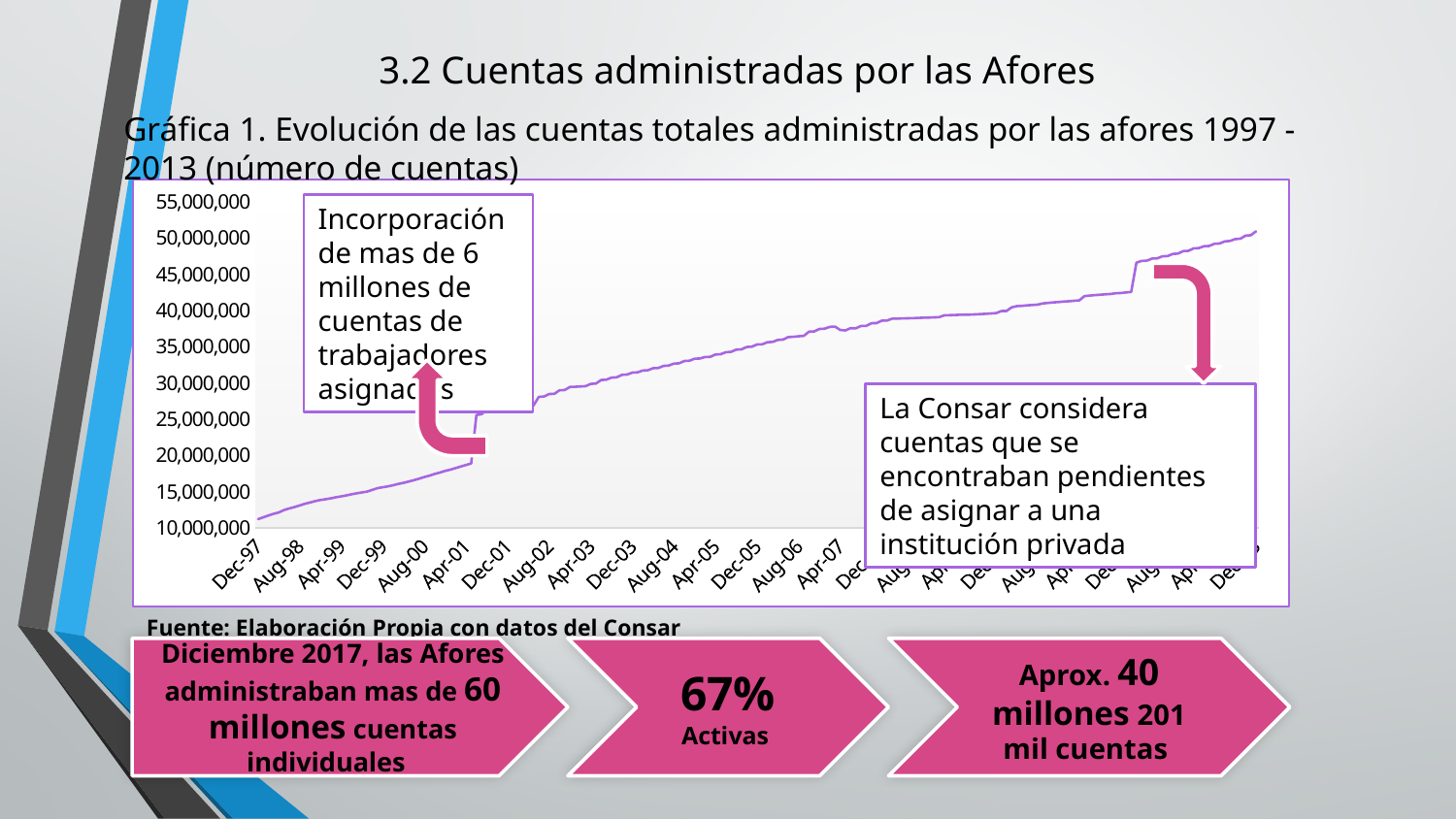
Which x-axis label corresponds to the lowest value on the line? Dec-97 Is the value at Apr-01 greater or less than 20,000,000? less Is the value at Dec-97 greater or less than 15,000,000? less What kind of chart is shown on the slide? line chart Is the value at Dec-05 greater or less than 30,000,000? greater What is the title of the chart (Gráfica 1)? Evolución de las cuentas totales administradas por las afores 1997 - 2013 (número de cuentas) What is the highest value shown on the y axis? 55,000,000 Is the value at Dec-05 larger or smaller than the value at Dec-99? larger Do the values in the chart generally rise or fall from left to right along the x axis? rise